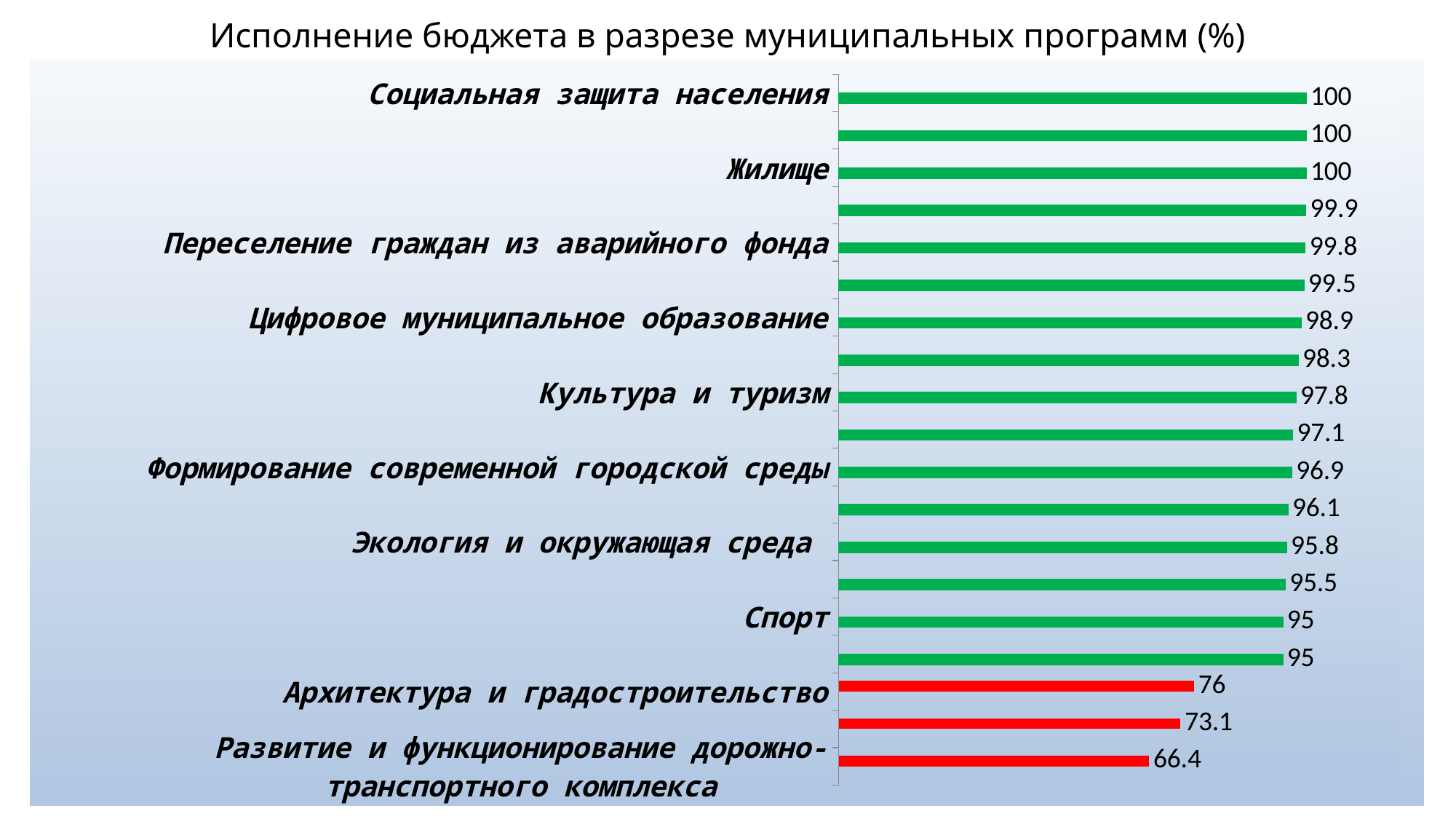
What is the value for Переселение граждан из аварийного фонда? 99.8 What is the value for Архитектура и градостроительство? 76 What kind of chart is shown on the slide? Bar chart Which labeled category has the lowest value? Развитие и функционирование дорожно-транспортного комплекса What is the difference between the values for Жилище and Экология и окружающая среда? 4.2 What is the value for Социальная защита населения? 100 What is the difference between the values for Спорт and Архитектура и градостроительство? 19 How many bars are coloured red? 3 What is the value for Развитие и функционирование дорожно-транспортного комплекса? 66.4 What is the value for Культура и туризм? 97.8 Which is larger, the value for Цифровое муниципальное образование or the value for Формирование современной городской среды? Цифровое муниципальное образование How many bars are plotted in the chart? 19